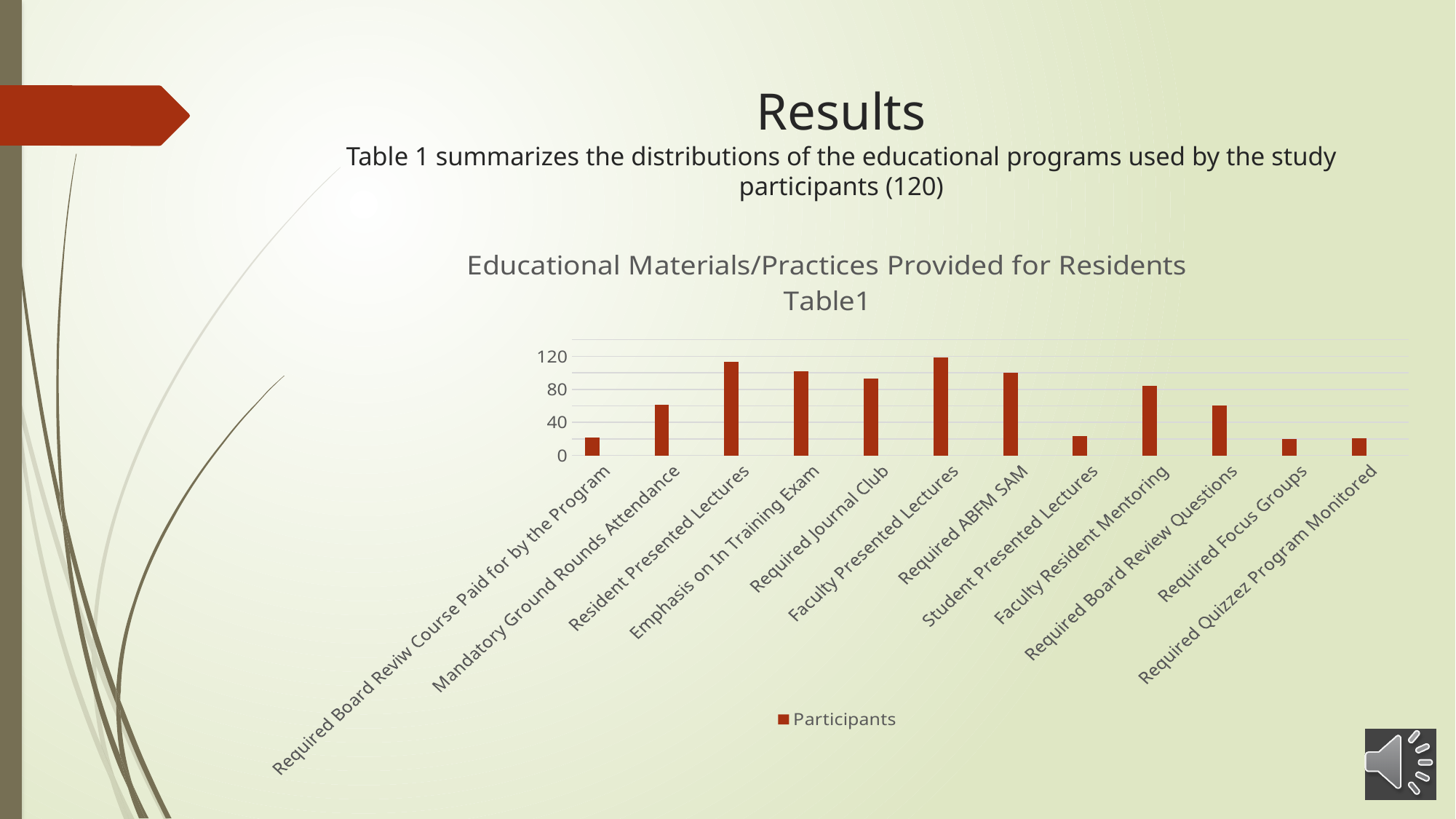
Which has a larger value, Faculty Resident Mentoring or Required Board Review Questions? Faculty Resident Mentoring Is the value for Resident Presented Lectures greater or less than 80? greater What is the name of the series shown in the chart's legend? Participants What kind of chart is shown on the slide? Bar chart How many series does the chart's legend list? 1 Which has a larger value, Resident Presented Lectures or Student Presented Lectures? Resident Presented Lectures Is the value for Required Focus Groups greater or less than 40? less Is the value for Student Presented Lectures greater or less than 40? less What is the title of the chart? Educational Materials/Practices Provided for Residents Table1 How many categories are plotted in the chart? 12 Which category has the highest value in the chart? Faculty Presented Lectures